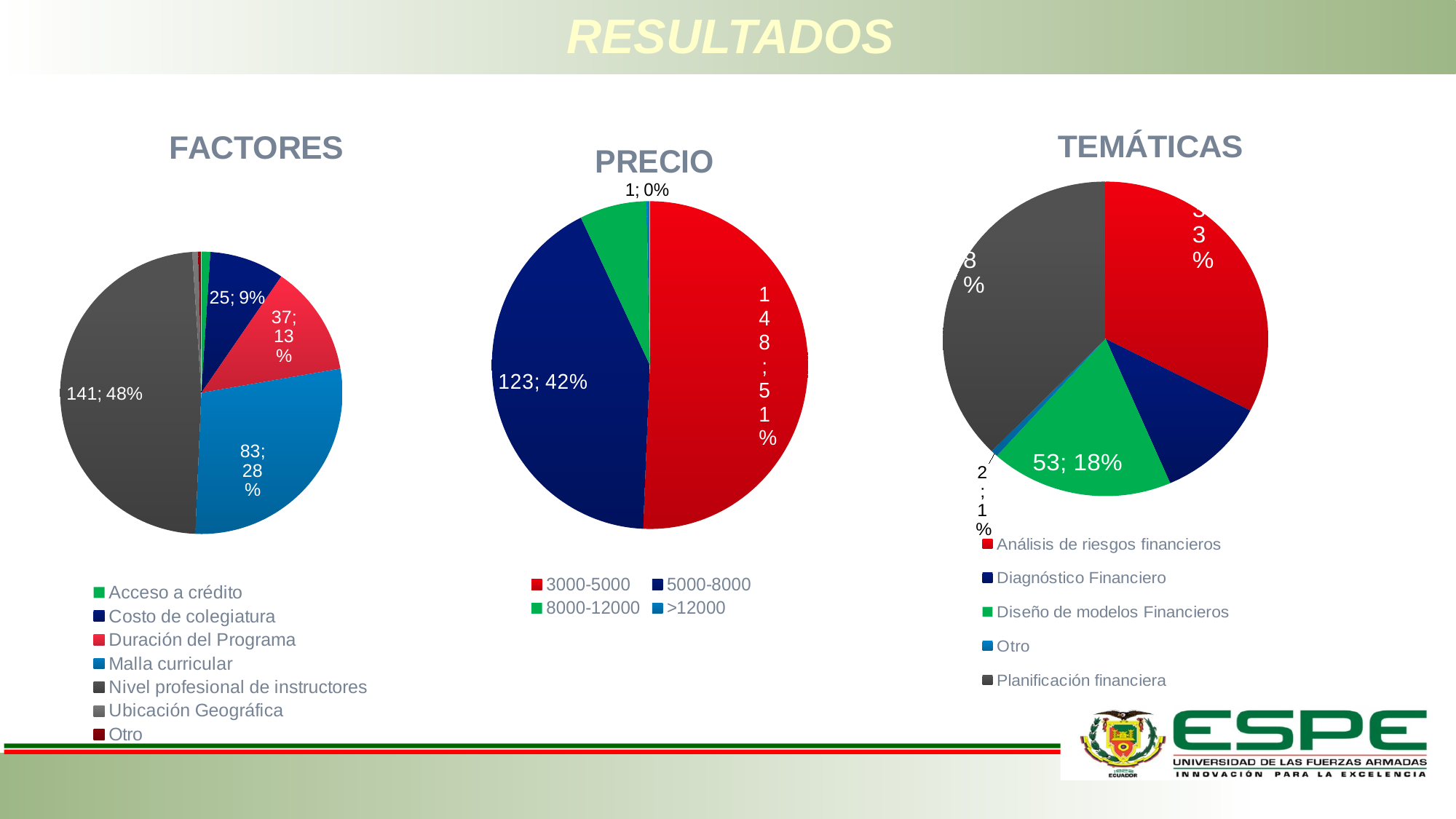
In the PRECIO chart, what is the difference between the counts for 3000-5000 and 5000-8000? 25 What kind of chart is the PRECIO chart? Pie chart In the PRECIO chart, what value is shown for the 3000-5000 range? 148; 51% In the FACTORES chart, what share of the pie does Malla curricular represent? 28% How many categories does the legend of the FACTORES chart list? 7 In the TEMÁTICAS chart, which is larger: Diseño de modelos Financieros or Otro? Diseño de modelos Financieros In the PRECIO chart, which price range has the smallest slice? >12000 In the TEMÁTICAS chart, what value is shown for Diseño de modelos Financieros? 53; 18% In the PRECIO chart, what value is shown for the 5000-8000 range? 123; 42% In the FACTORES chart, what is the difference between the counts for Nivel profesional de instructores and Malla curricular? 58 In the FACTORES chart, what value is shown for Nivel profesional de instructores? 141; 48% In the FACTORES chart, which category has the largest slice? Nivel profesional de instructores